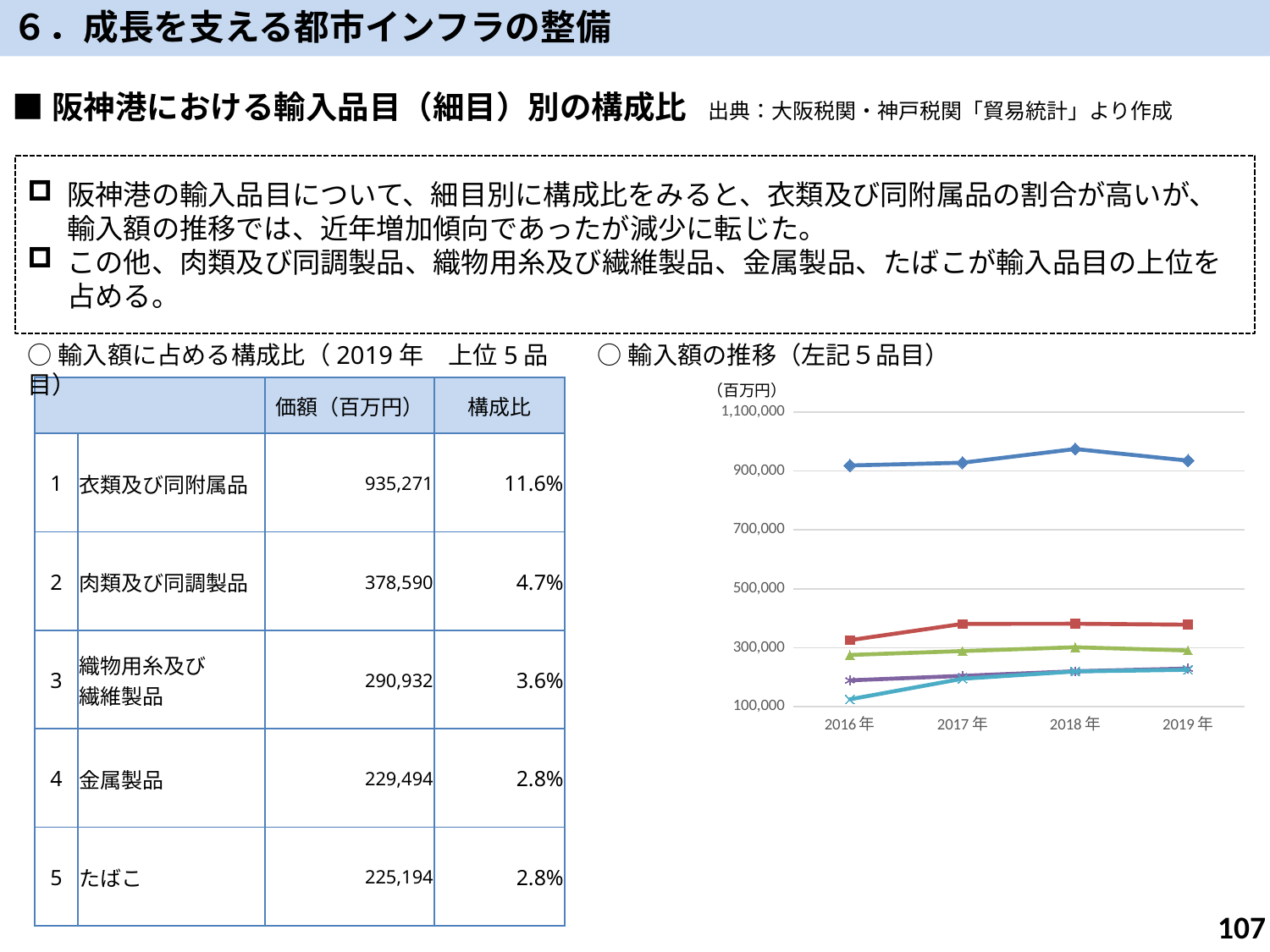
In the 輸入額の推移 chart, in which year does the topmost (blue diamond) line reach its highest value? 2018年 How many lines are plotted in the 輸入額の推移 chart? 5 In the 輸入額の推移 chart, which year has the larger value for the topmost (blue diamond) line, 2018年 or 2019年? 2018年 In the 輸入額の推移 chart, does the red square line rise or fall from 2016年 to 2017年? rise What kind of chart is the 輸入額の推移（左記5品目） chart? line chart In the 輸入額の推移 chart, does the topmost (blue diamond) line rise or fall from 2018年 to 2019年? fall In the 輸入額の推移 chart, is the 2018年 value of the topmost (blue diamond) line greater or less than 900,000? greater In the 輸入額の推移 chart, is the 2016年 value of the red square line greater or less than 500,000? less In the 輸入額の推移 chart, in which year is the lowest (light blue x-marker) line at its lowest value? 2016年 How many years are shown on the x axis of the 輸入額の推移 chart? 4 In the 輸入額の推移 chart, is the 2017年 value of the red square line greater or less than 300,000? greater What unit is shown on the y axis of the 輸入額の推移 chart? 百万円